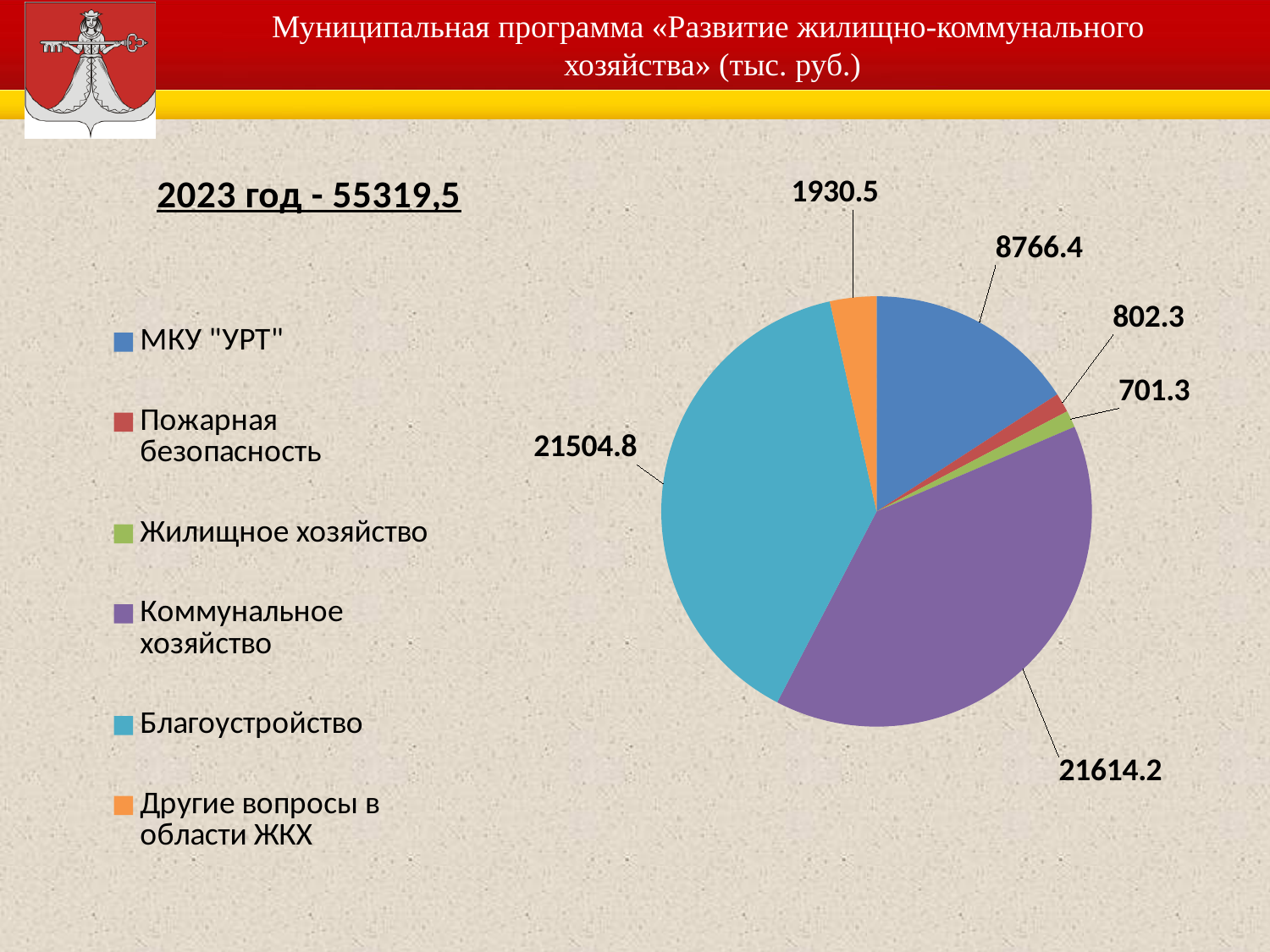
Which is larger, МКУ "УРТ" or Другие вопросы в области ЖКХ? МКУ "УРТ" What is the value for МКУ "УРТ"? 8766.4 What is the value for Другие вопросы в области ЖКХ? 1930.5 What kind of chart is shown on the slide? pie chart What is the value for Пожарная безопасность? 802.3 Which category has the smallest value? Жилищное хозяйство What is the value for Коммунальное хозяйство? 21614.2 What is the value for Благоустройство? 21504.8 What is the total for 2023 shown on the slide? 55319,5 Which category has the largest value? Коммунальное хозяйство What is the difference between Коммунальное хозяйство and Благоустройство? 109.4 How many categories does the pie chart have? 6